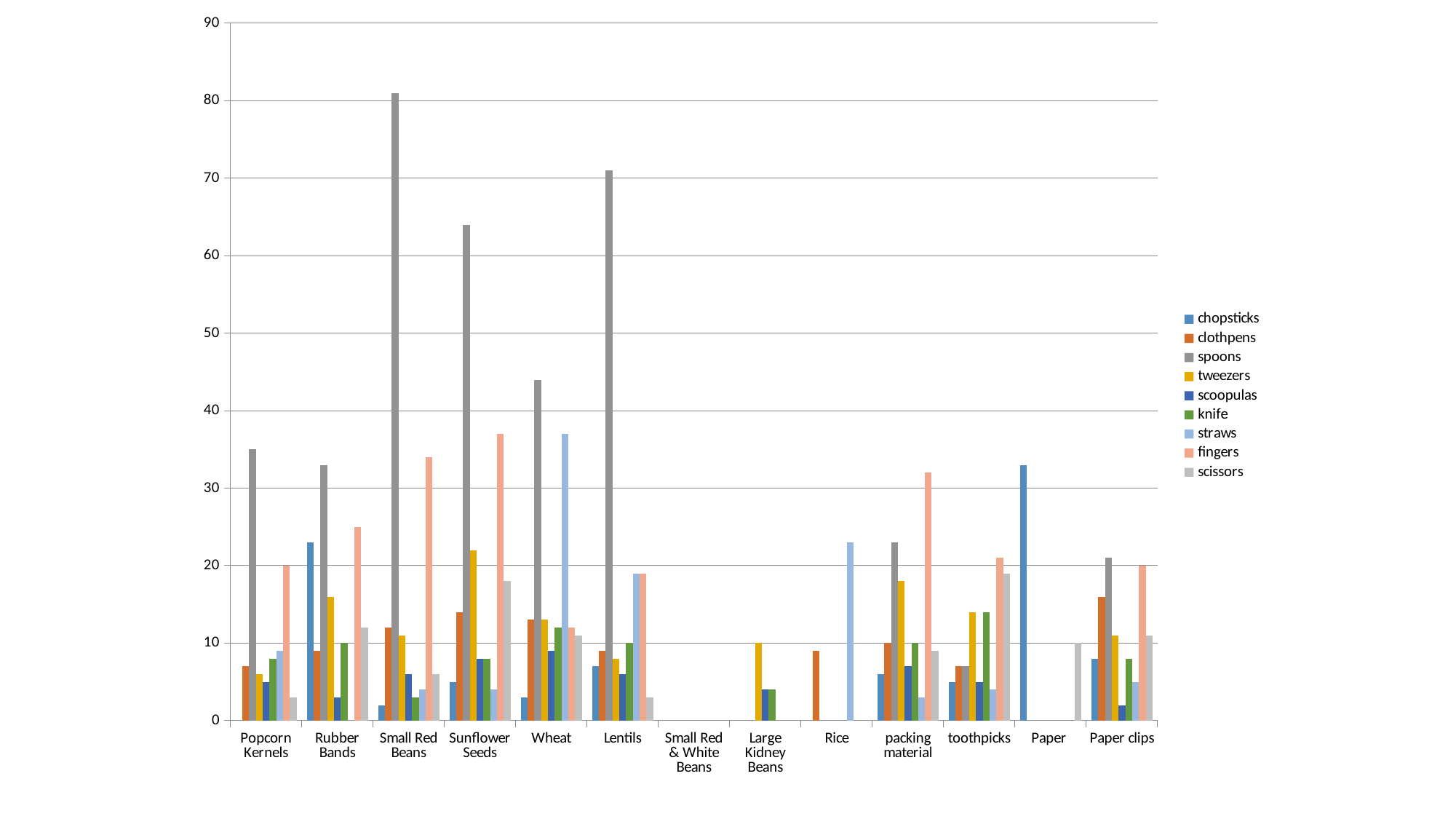
Is the value for straws for Rice greater or less than 20? greater Is the value for straws for Wheat greater or less than 30? greater How many series does the legend list? 9 Which series has the highest value for Rubber Bands? spoons Which is larger, the spoons value for Small Red Beans or the spoons value for Lentils? Small Red Beans How many categories are shown along the x axis? 13 Is the value for spoons for Sunflower Seeds greater or less than 70? less Which series is shown in the darkest grey colour in the legend? spoons Which category has the highest value for spoons? Small Red Beans What kind of chart is shown on the slide? bar chart